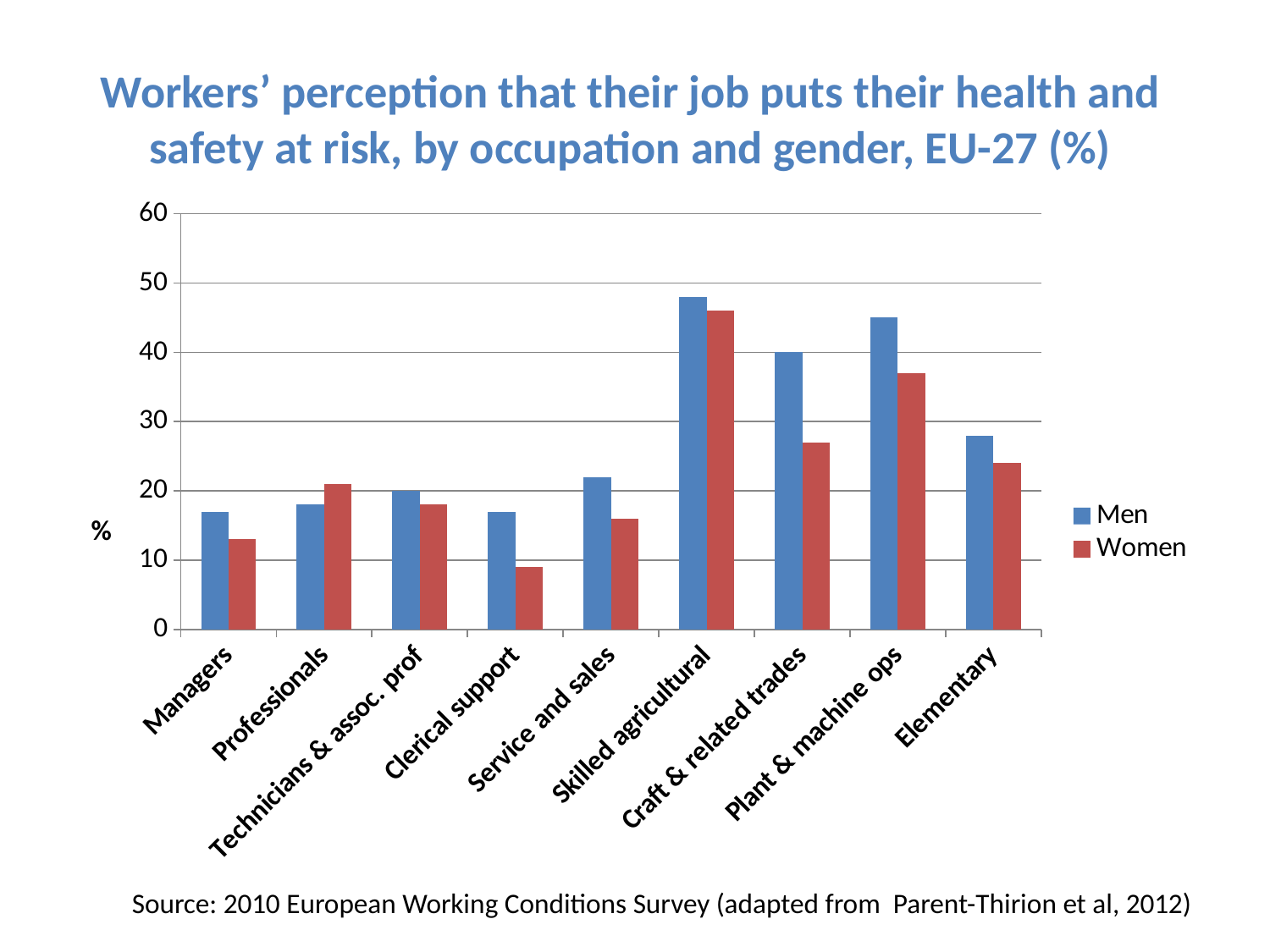
Which occupation has the lowest value for Women? Clerical support How many occupation categories are shown on the x axis? 9 For Craft & related trades, which is larger, the value for Men or for Women? Men Which occupation has the highest value for Men? Skilled agricultural What are the two series named in the legend? Men and Women Which occupation has the highest value for Women? Skilled agricultural For Professionals, which is larger, the value for Men or for Women? Women What kind of chart is shown on the slide? bar chart Is the value for Men in Craft & related trades greater or less than 30? greater Is the value for Women in Plant & machine ops greater or less than 30? greater How many series does the legend list? 2 Is the value for Men in Managers greater or less than 20? less